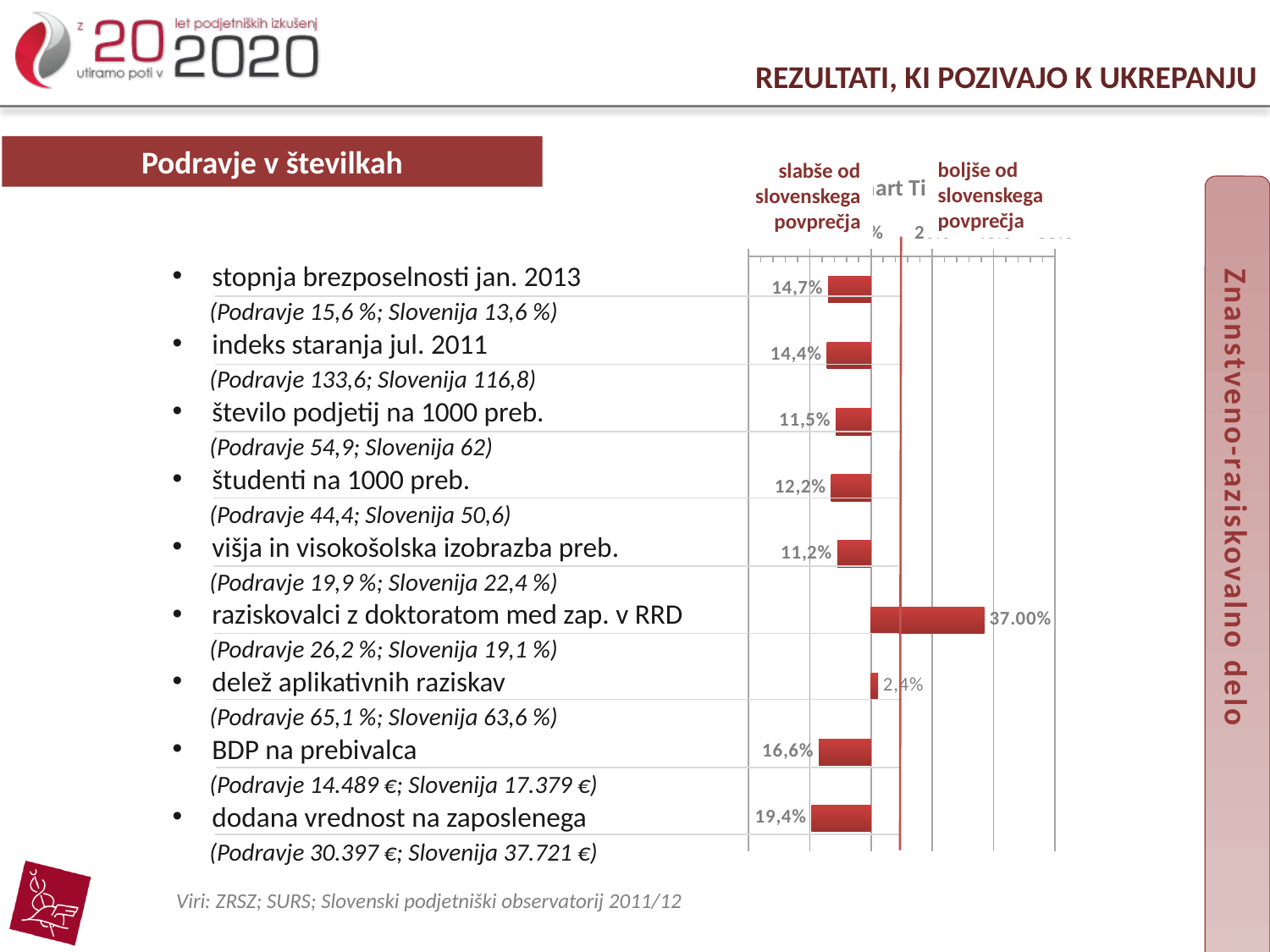
What value is labelled on the bar for 'raziskovalci z doktoratom med zap. v RRD'? 37.00% What value is labelled on the bar for 'delež aplikativnih raziskav'? 2,4% How many bars are plotted in the chart? 9 Which has the larger labelled value: 'indeks staranja jul. 2011' or 'število podjetij na 1000 preb.'? indeks staranja jul. 2011 What value is labelled on the bar for 'BDP na prebivalca'? 16,6% What is the difference between the labelled values for 'dodana vrednost na zaposlenega' (19,4%) and 'BDP na prebivalca' (16,6%)? 2,8 percentage points What kind of chart is shown on the slide? bar chart How many bars extend to the right of the red vertical line, on the 'boljše od slovenskega povprečja' side? 2 Which category has the shortest bar in the chart? delež aplikativnih raziskav What value is labelled on the bar for 'dodana vrednost na zaposlenega'? 19,4% Which category has the longest bar in the chart? raziskovalci z doktoratom med zap. v RRD What value is labelled on the bar for 'stopnja brezposelnosti jan. 2013'? 14,7%